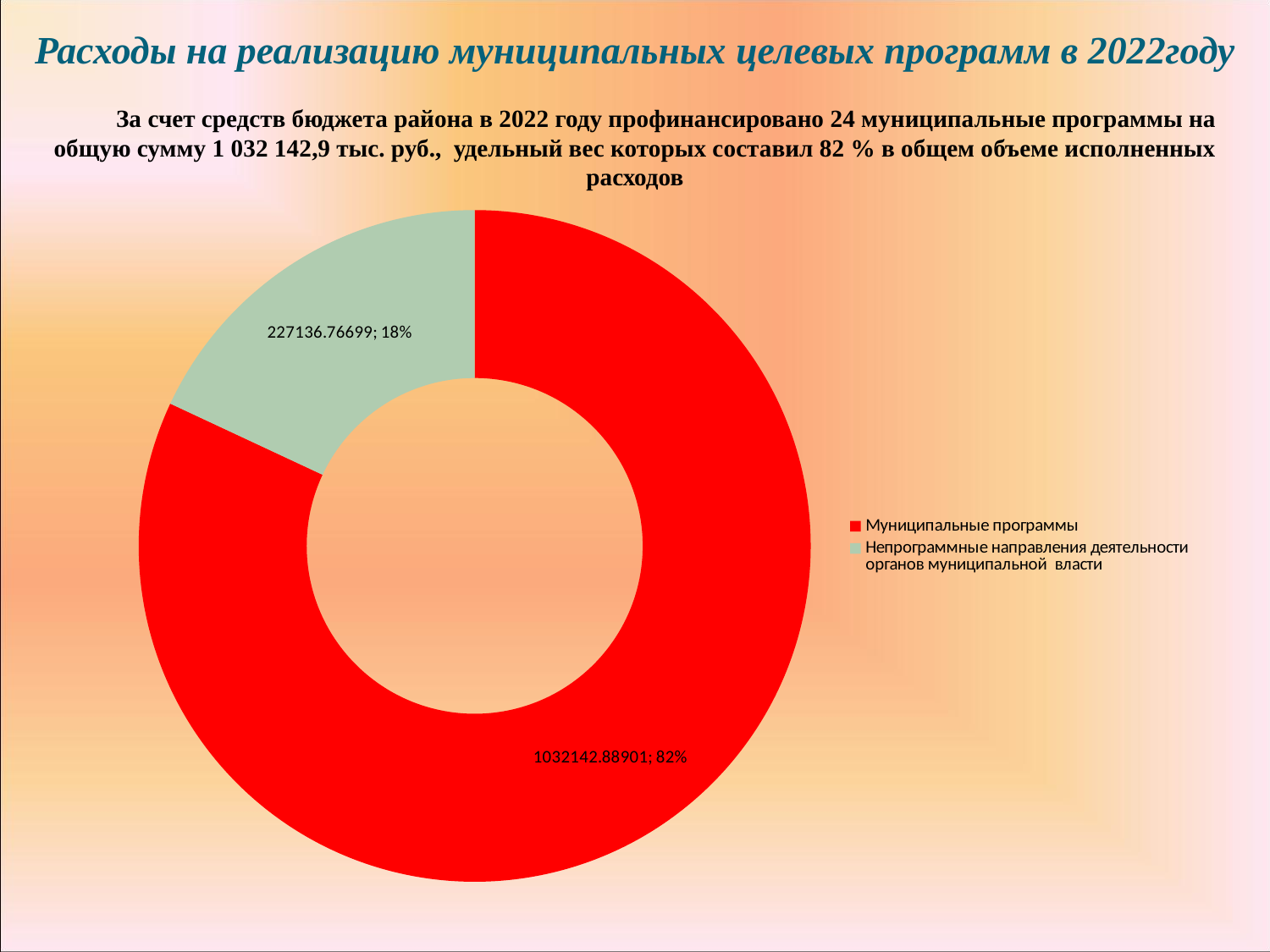
What is the value for Непрограммные направления деятельности органов муниципальной власти? 227136.76699 What share of the chart does Муниципальные программы take? 82% Which is larger: Муниципальные программы or Непрограммные направления деятельности органов муниципальной власти? Муниципальные программы What is the value for Муниципальные программы? 1032142.88901 How many categories does the chart show? 2 What is the difference between the values for Муниципальные программы and Непрограммные направления деятельности органов муниципальной власти? 805006.12202 What kind of chart is shown on the slide? doughnut chart What is the total of the two values shown in the chart? 1259279.656 Which category has the smallest slice? Непрограммные направления деятельности органов муниципальной власти Which category has the largest slice? Муниципальные программы What colour is the slice for Муниципальные программы? red What share of the chart does Непрограммные направления деятельности органов муниципальной власти take? 18%